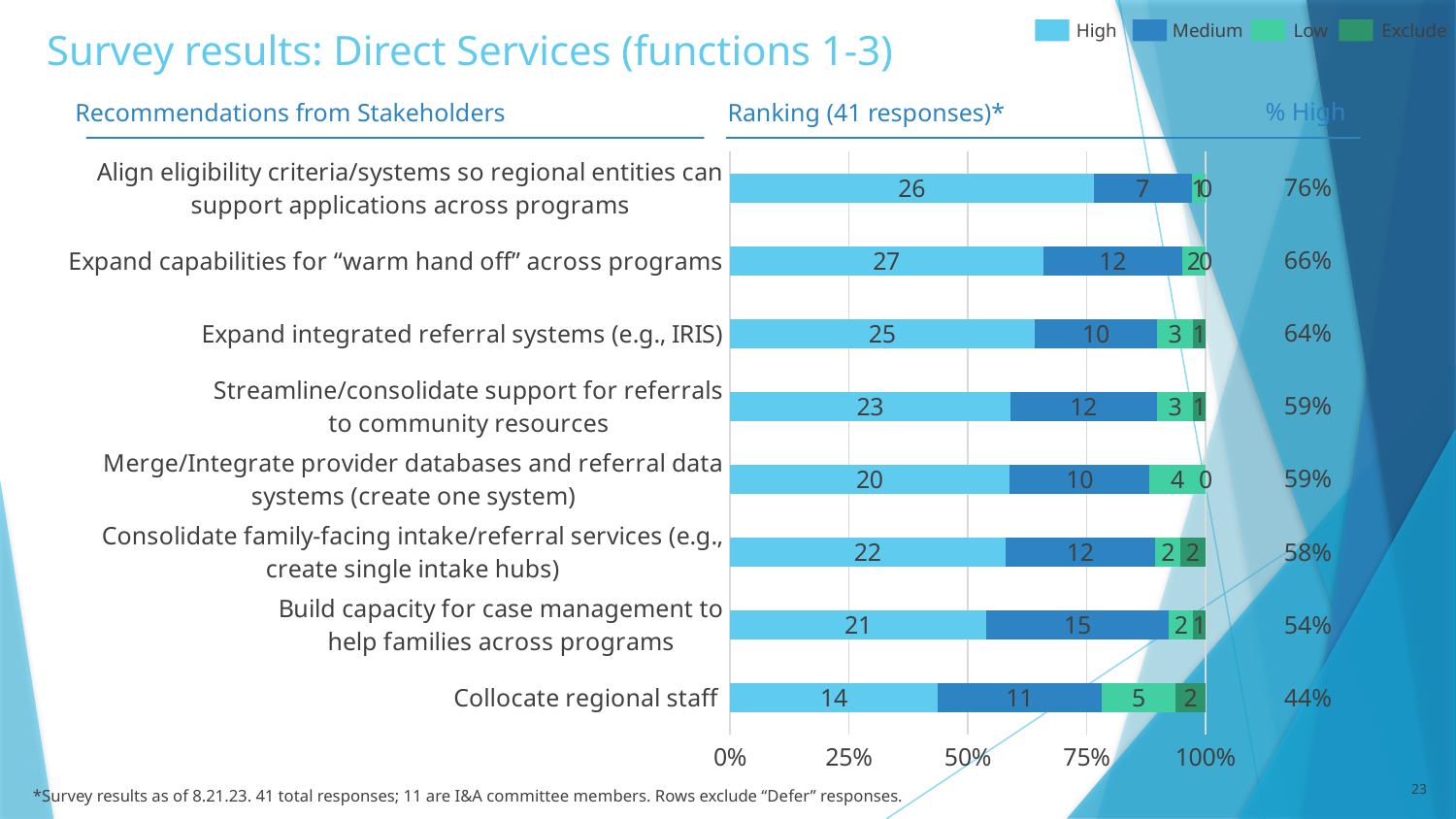
What is the first entry listed in the chart legend? High Which recommendation has the lowest High count? Collocate regional staff Which has a larger Medium count: "Build capacity for case management to help families across programs" or "Expand integrated referral systems (e.g., IRIS)"? Build capacity for case management to help families across programs What is the total number of responses in the "Collocate regional staff" bar? 32 For "Collocate regional staff", what is the difference between the High count and the Medium count? 3 Which recommendation has the highest High count? Expand capabilities for "warm hand off" across programs What is the Low count for "Collocate regional staff"? 5 What is the High count for "Collocate regional staff"? 14 How many recommendations (bars) are plotted in the chart? 8 What is the Medium count for "Build capacity for case management to help families across programs"? 15 How many series does the chart legend list? 4 What kind of chart is shown on the slide? Stacked bar chart